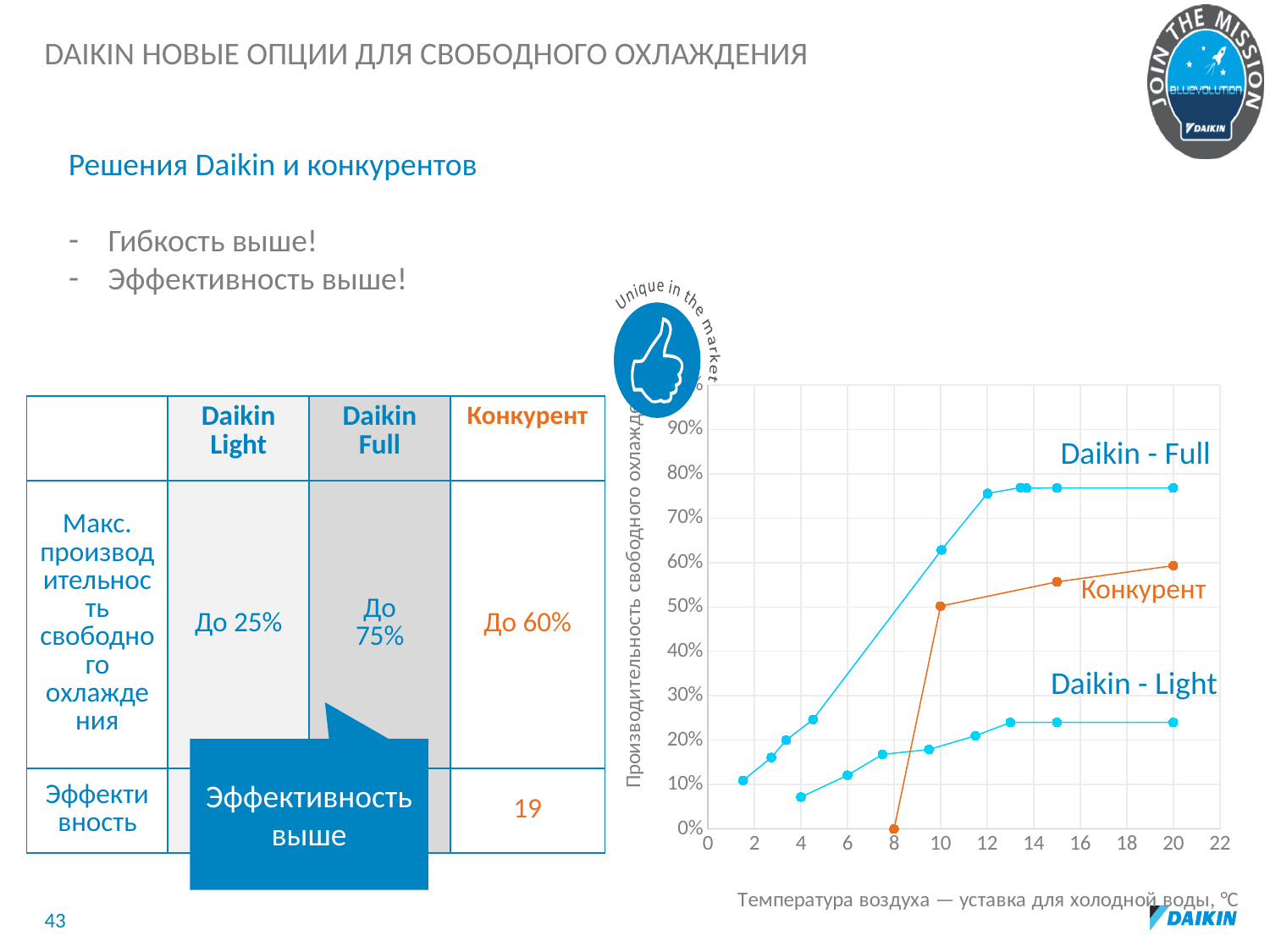
Do the values for Daikin - Full rise or fall as the air temperature increases from 2 to 12? rise How many series are plotted on the chart? 3 Is the value for Конкурент at 20 greater or less than 50%? greater Which series reaches the highest value on the chart? Daikin - Full What is the title of the x axis of the chart? Температура воздуха — уставка для холодной воды, °C Is the value for Daikin - Light at 20 greater or less than 30%? less What kind of chart is shown on the slide? line chart Which series has the lowest values at an air temperature of 20? Daikin - Light What is the title of the y axis of the chart? Производительность свободного охлаждения What is the value for Конкурент at an air temperature of 8? 0% Is the value for Daikin - Full at 20 greater or less than 70%? greater At an air temperature of 10, which is larger: Daikin - Full or Конкурент? Daikin - Full